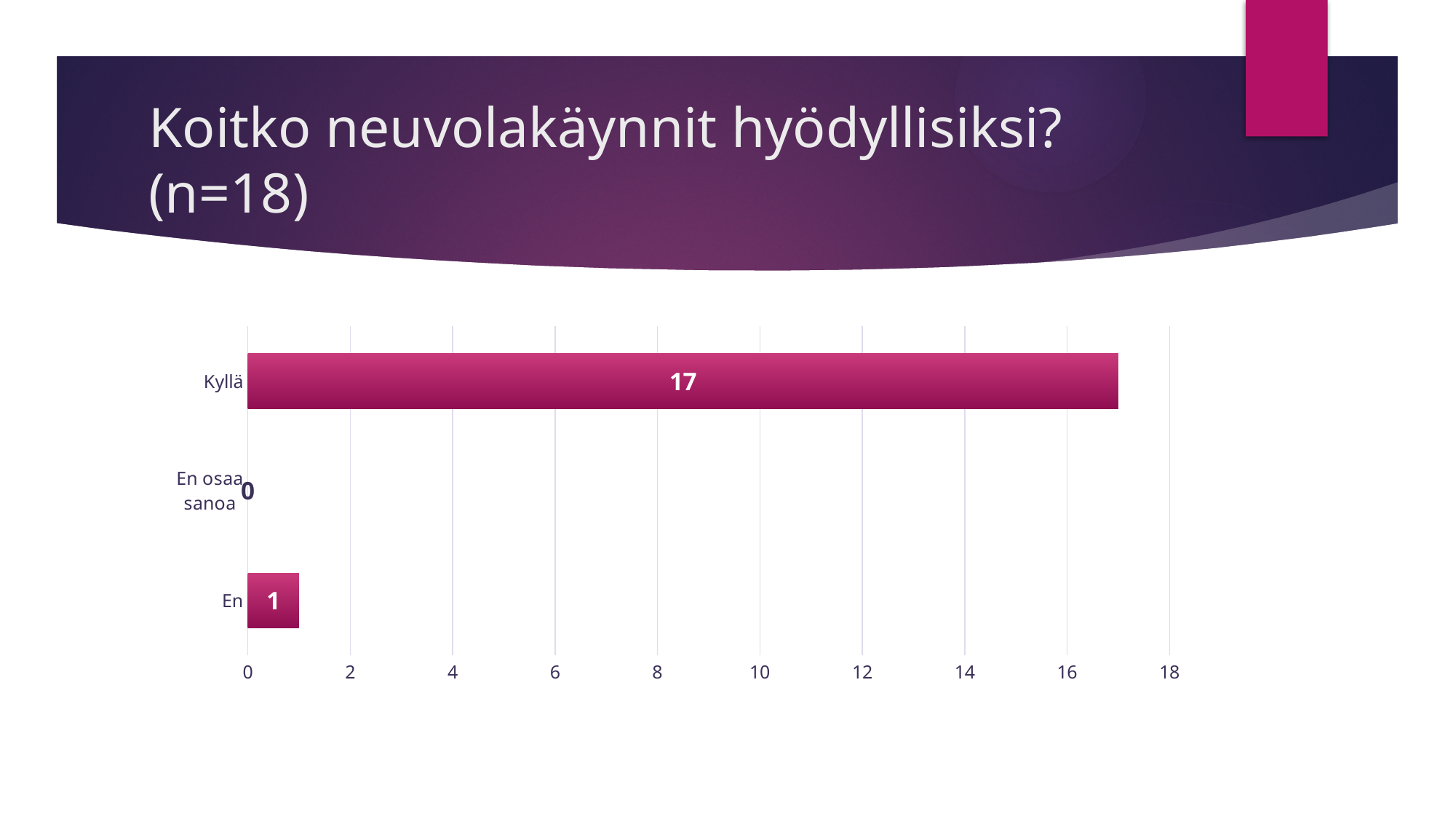
What is the difference between the values for Kyllä and En? 16 Which category has the lowest value? En osaa sanoa What is the value for Kyllä? 17 What kind of chart is shown on the slide? bar chart Is the value for Kyllä greater or less than 10? greater What is the value for En osaa sanoa? 0 Which is larger, the value for Kyllä or the value for En? Kyllä What is the total of all three values in the chart? 18 What is the title of the slide? Koitko neuvolakäynnit hyödyllisiksi? (n=18) Which category has the highest value? Kyllä How many categories are shown in the chart? 3 What is the value for En? 1